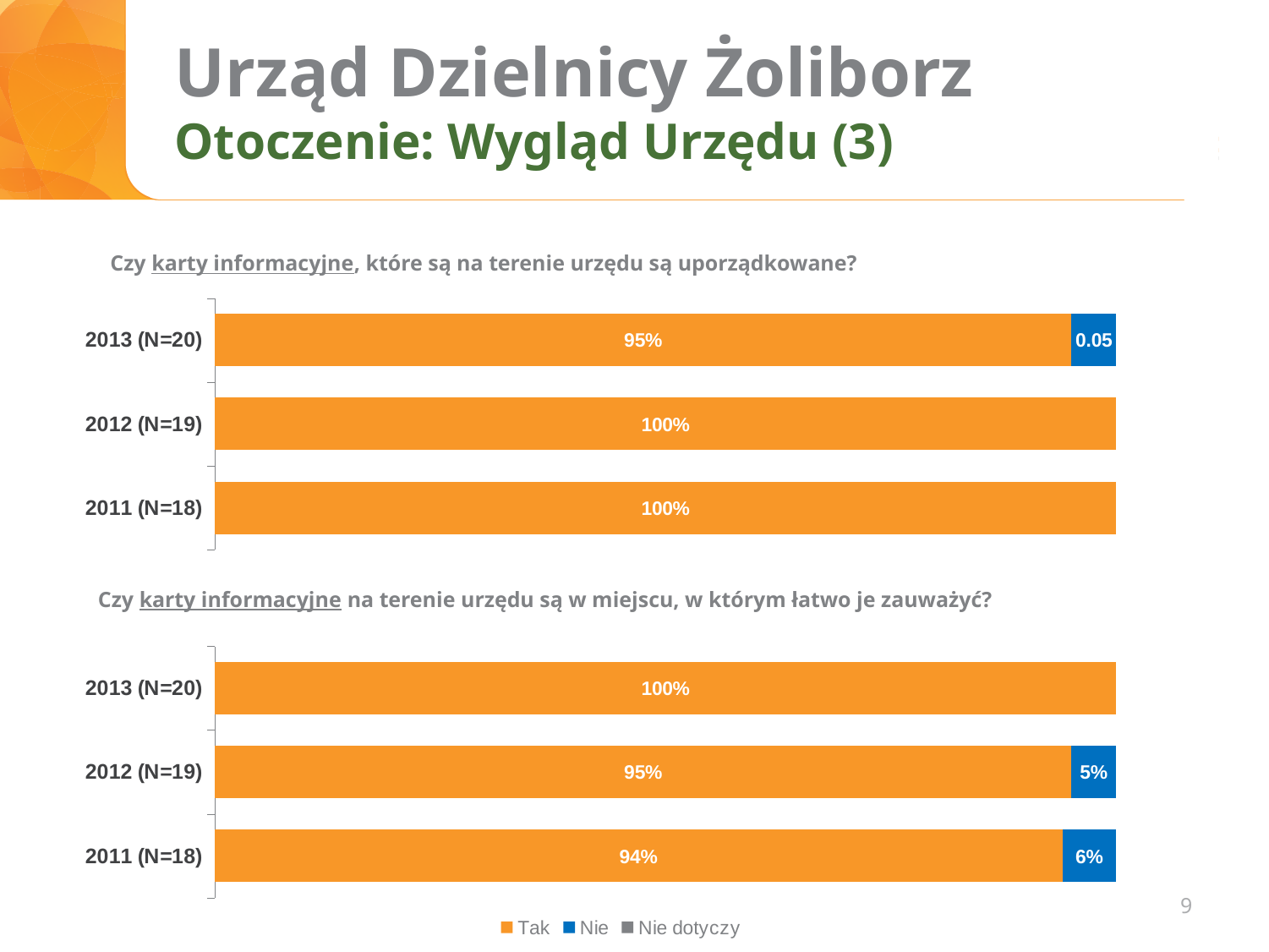
How many series does the legend at the bottom of the slide list? 3 What type of chart is the top chart ("Czy karty informacyjne, które są na terenie urzędu są uporządkowane?")? Stacked bar chart In the top chart ("Czy karty informacyjne, które są na terenie urzędu są uporządkowane?"), what is the "Tak" value for 2012 (N=19)? 100% In the top chart ("Czy karty informacyjne, które są na terenie urzędu są uporządkowane?"), which year has the lowest "Tak" value? 2013 (N=20) In the bottom chart ("Czy karty informacyjne na terenie urzędu są w miejscu, w którym łatwo je zauważyć?"), what is the "Nie" value for 2012 (N=19)? 5% In the top chart ("Czy karty informacyjne, które są na terenie urzędu są uporządkowane?"), what is the "Tak" value for 2013 (N=20)? 95% In the bottom chart ("Czy karty informacyjne na terenie urzędu są w miejscu, w którym łatwo je zauważyć?"), which year has the highest "Tak" value? 2013 (N=20) In the bottom chart ("Czy karty informacyjne na terenie urzędu są w miejscu, w którym łatwo je zauważyć?"), is the "Nie" value larger for 2011 (N=18) or 2012 (N=19)? 2011 (N=18) In the top chart ("Czy karty informacyjne, które są na terenie urzędu są uporządkowane?"), what label is shown on the blue "Nie" segment for 2013 (N=20)? 0.05 In the bottom chart ("Czy karty informacyjne na terenie urzędu są w miejscu, w którym łatwo je zauważyć?"), what is the difference between the "Tak" values for 2013 (N=20) and 2011 (N=18)? 6% In the bottom chart ("Czy karty informacyjne na terenie urzędu są w miejscu, w którym łatwo je zauważyć?"), what is the "Tak" value for 2011 (N=18)? 94% How many year categories does the bottom chart ("Czy karty informacyjne na terenie urzędu są w miejscu, w którym łatwo je zauważyć?") show? 3